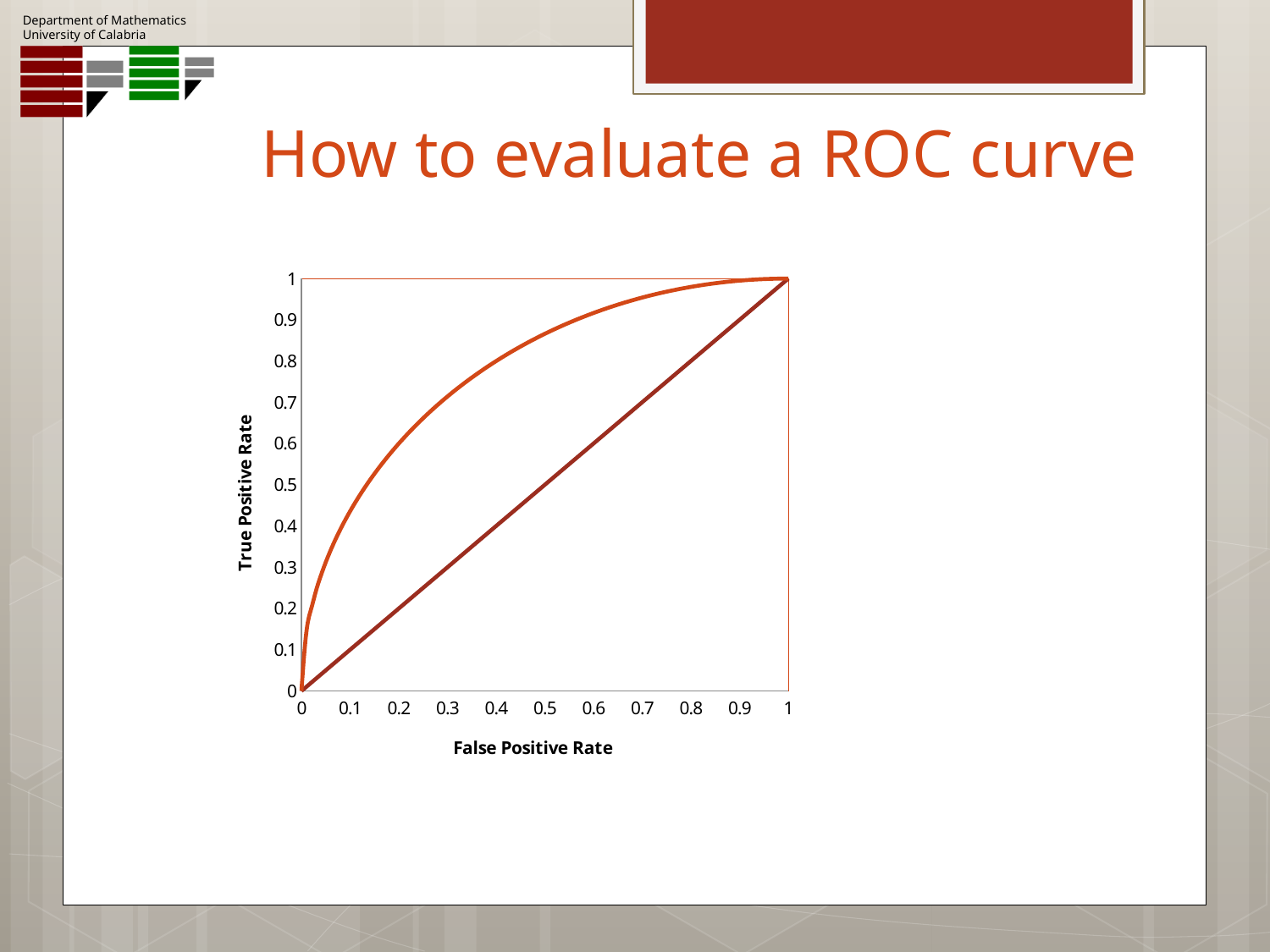
Does the curved orange line rise or fall as the False Positive Rate increases from 0 to 1? rise How many lines are plotted on the chart? 2 What is the title of the y axis of the chart? True Positive Rate At a False Positive Rate of 0.3, which line has the higher True Positive Rate, the curved orange line or the straight diagonal line? the curved orange line What kind of chart is shown on the slide? line chart What True Positive Rate do both lines reach at a False Positive Rate of 1? 1 Is the True Positive Rate of the curved orange line at a False Positive Rate of 0.5 greater or less than 0.7? greater Is the True Positive Rate of the curved orange line at a False Positive Rate of 0.1 greater or less than 0.3? greater What is the True Positive Rate of the straight diagonal line at a False Positive Rate of 0.5? 0.5 What is the title of the x axis of the chart? False Positive Rate Is the True Positive Rate of the straight diagonal line at a False Positive Rate of 0.3 greater or less than 0.5? less Does the straight diagonal line rise or fall as the False Positive Rate increases? rise